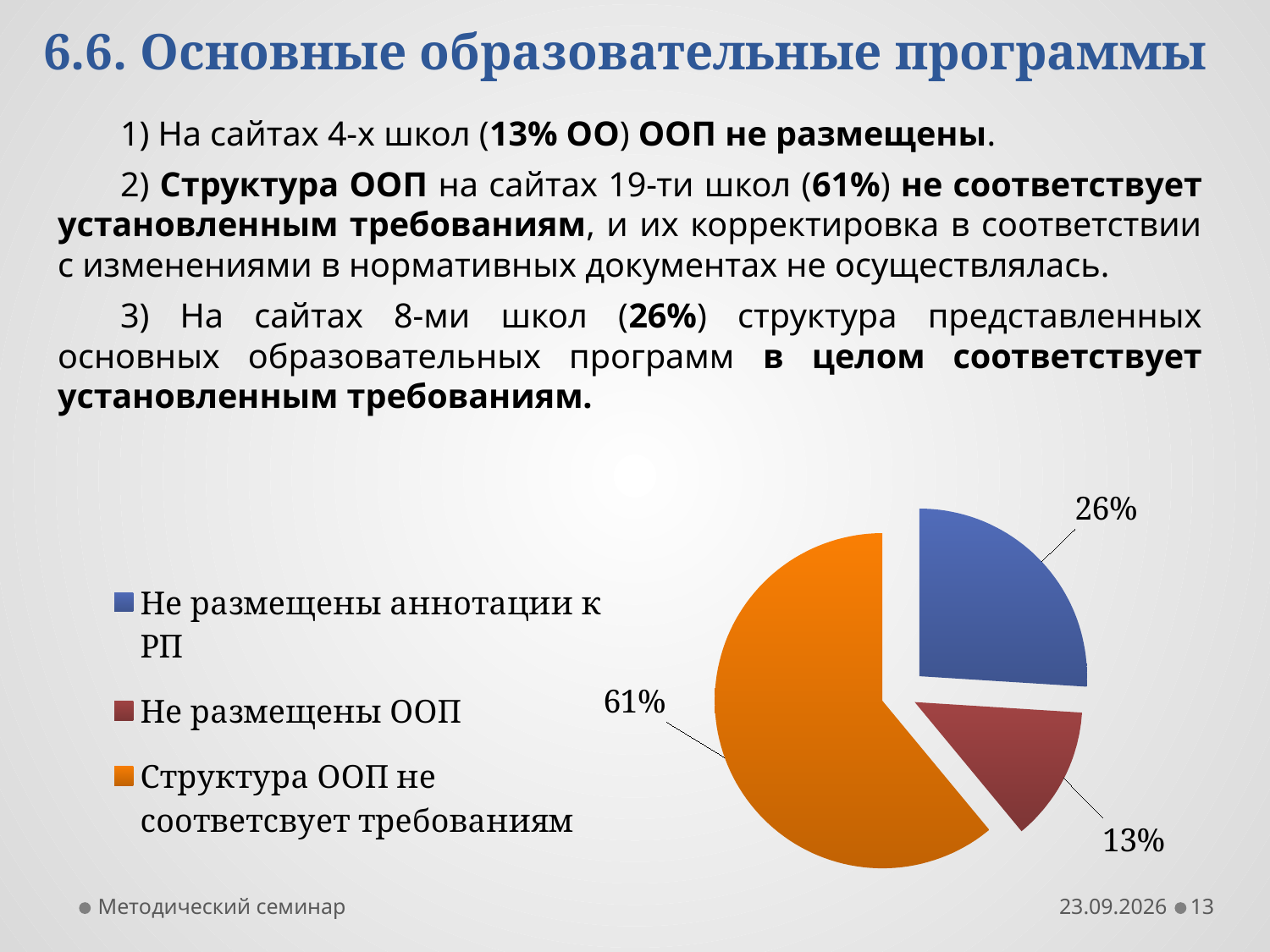
Which slice of the pie chart is the smallest? Не размещены ООП What colour is the slice for "Не размещены ООП" in the pie chart? red What is the value shown for "Не размещены аннотации к РП" in the pie chart? 26% How many entries does the legend of the pie chart list? 3 What kind of chart is shown on the slide? pie chart Which is larger in the pie chart: "Не размещены аннотации к РП" or "Не размещены ООП"? Не размещены аннотации к РП What share of the pie does the slice "Структура ООП не соответсвует требованиям" take? 61% Which slice of the pie chart is the largest? Структура ООП не соответсвует требованиям What is the value shown for "Не размещены ООП" in the pie chart? 13% What colour is the largest slice of the pie chart? orange How many slices does the pie chart have? 3 What is the difference between the "Структура ООП не соответсвует требованиям" slice and the "Не размещены аннотации к РП" slice? 35%